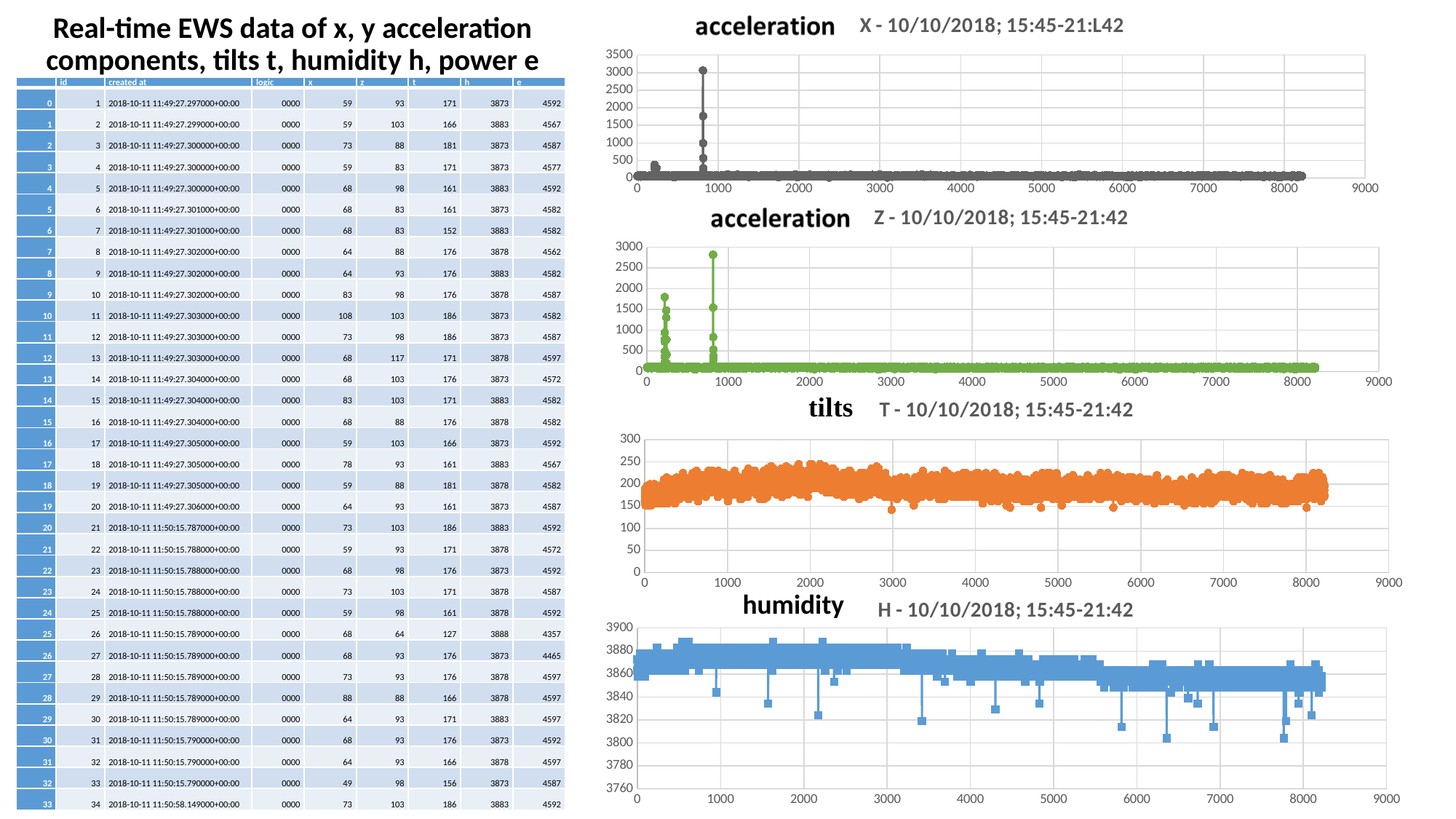
In the 'H - 10/10/2018; 15:45-21:42' humidity chart, is the lowest plotted value greater or less than 3780? greater In the 'H - 10/10/2018; 15:45-21:42' humidity chart, do the values generally rise or fall along the x axis? fall In the 'T - 10/10/2018; 15:45-21:42' tilts chart, is the highest plotted value greater or less than 300? less How many charts are shown on the slide? 4 In the 'Z - 10/10/2018; 15:45-21:42' acceleration chart, is the highest spike greater or less than 2500? greater What kind of chart is the 'X - 10/10/2018; 15:45-21:L42' acceleration chart? scatter chart What is the highest y-axis tick shown on the 'H - 10/10/2018; 15:45-21:42' humidity chart? 3900 What colour are the markers in the 'T - 10/10/2018; 15:45-21:42' tilts chart? orange